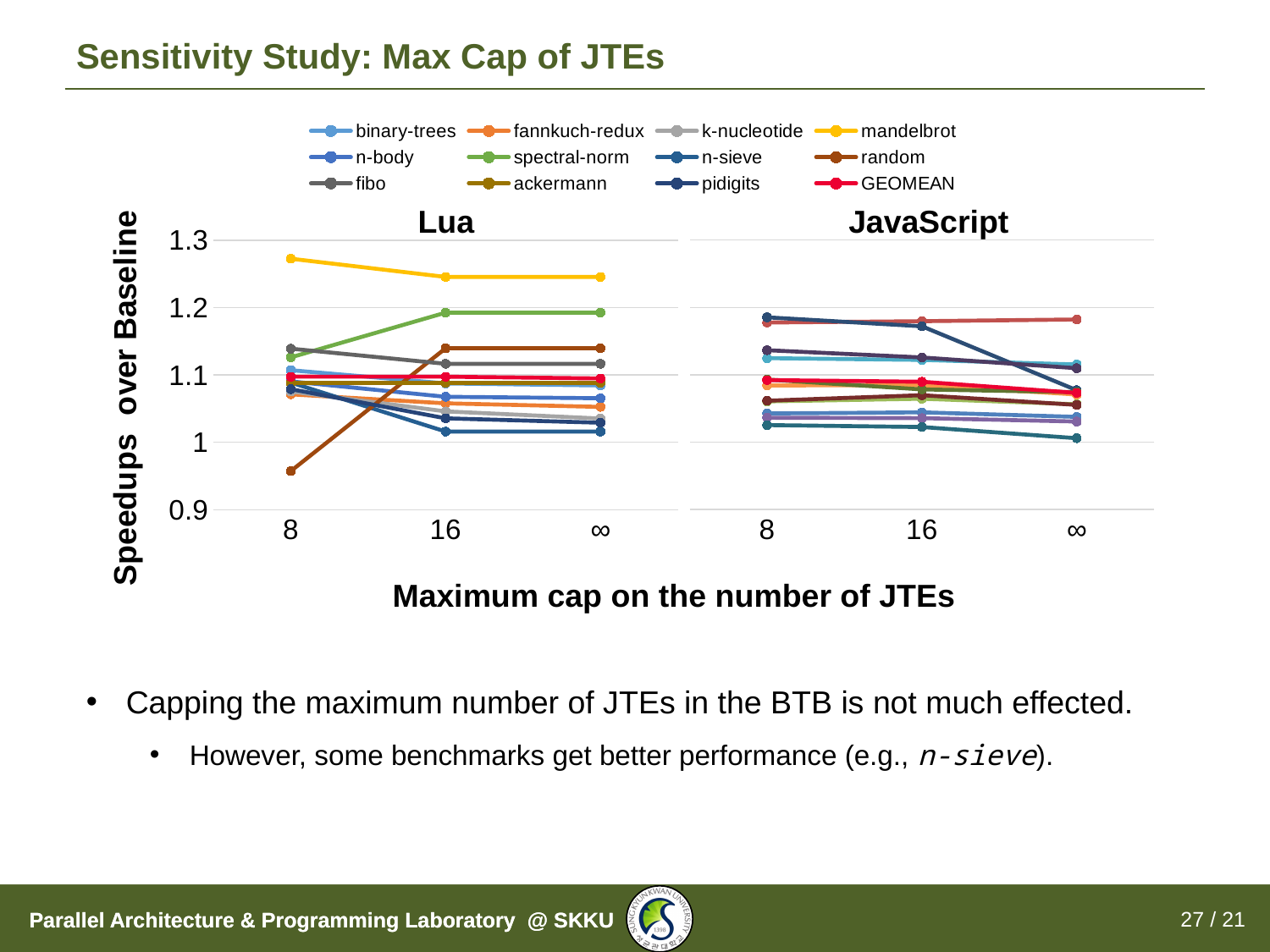
In the Lua chart, which is larger at a cap of 8: mandelbrot or random? mandelbrot In the Lua chart, how many x-axis categories (cap values) are plotted? 3 In the Lua chart, which series has the highest speedup at a cap of 8? mandelbrot In the Lua chart, is the value for random at a cap of 8 greater or less than 1? less What kind of chart is used on this slide for the Lua and JavaScript panels? line chart In the Lua chart, is the value for random at a cap of 16 greater or less than 1.1? greater In the Lua chart, is the value for mandelbrot at a cap of 8 greater or less than 1.2? greater In the Lua chart, which series has the lowest speedup at a cap of 8? random In the Lua chart, does the mandelbrot line rise or fall from a cap of 8 to a cap of 16? fall In the Lua chart, does the random line rise or fall from a cap of 8 to a cap of 16? rise What is the x-axis title shared by the two charts? Maximum cap on the number of JTEs How many series does the legend list? 12